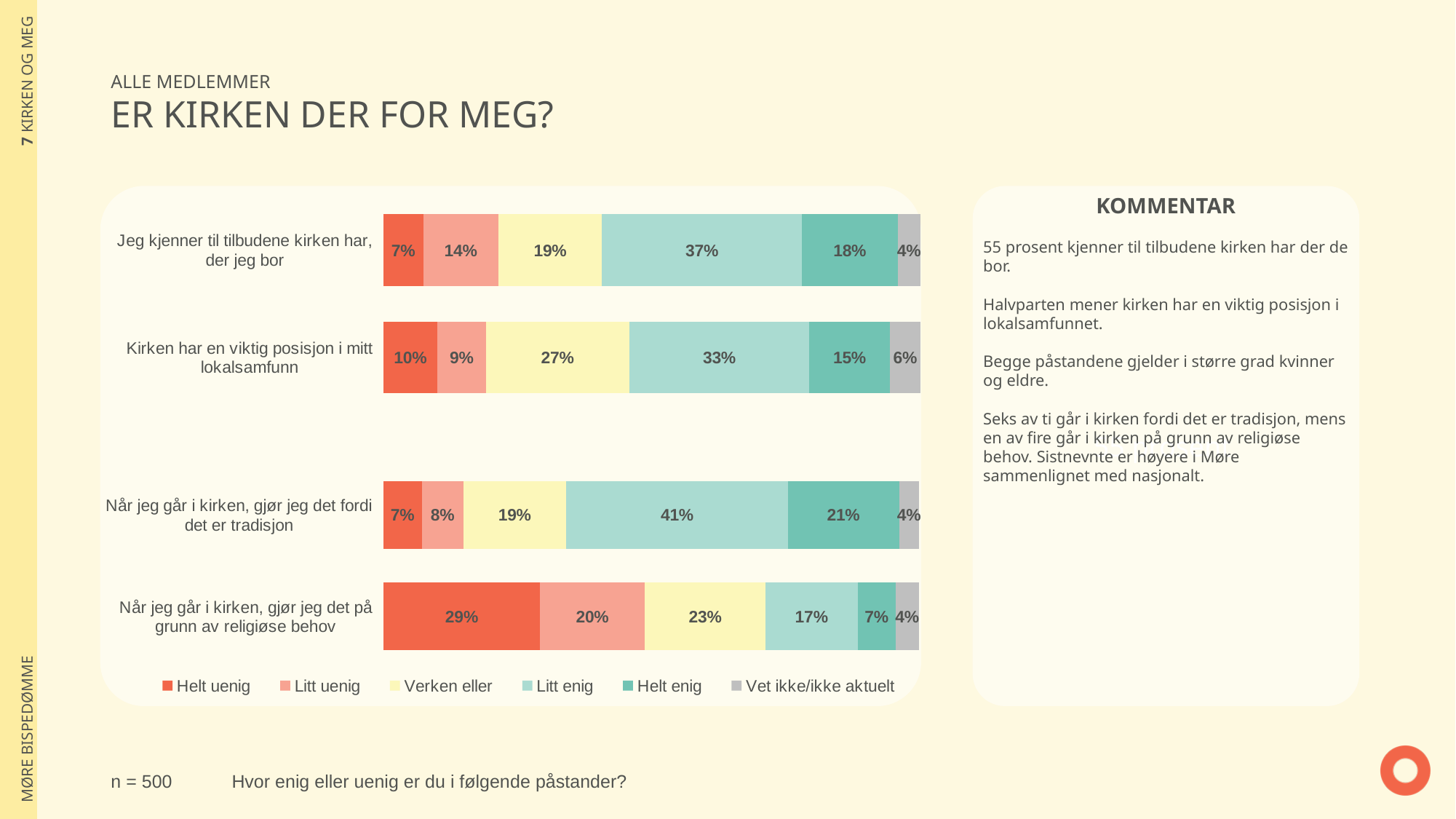
Which statement has the lowest 'Helt enig' value? Når jeg går i kirken, gjør jeg det på grunn av religiøse behov Which is larger: the 'Litt uenig' value for 'Jeg kjenner til tilbudene kirken har, der jeg bor' or for 'Kirken har en viktig posisjon i mitt lokalsamfunn'? Jeg kjenner til tilbudene kirken har, der jeg bor What is the total of all segments in the bar for 'Kirken har en viktig posisjon i mitt lokalsamfunn'? 100% How many statements (categories) are shown in the chart? 4 What is the 'Helt enig' value for 'Når jeg går i kirken, gjør jeg det fordi det er tradisjon'? 21% What kind of chart is shown on the slide? Stacked bar chart Which statement has the highest 'Helt uenig' value? Når jeg går i kirken, gjør jeg det på grunn av religiøse behov What is the 'Verken eller' value for 'Kirken har en viktig posisjon i mitt lokalsamfunn'? 27% What is the difference between the 'Litt enig' values for 'Når jeg går i kirken, gjør jeg det fordi det er tradisjon' and 'Når jeg går i kirken, gjør jeg det på grunn av religiøse behov'? 24% What is the 'Litt enig' value for 'Jeg kjenner til tilbudene kirken har, der jeg bor'? 37% How many series does the legend list? 6 What is the 'Helt uenig' value for 'Når jeg går i kirken, gjør jeg det på grunn av religiøse behov'? 29%